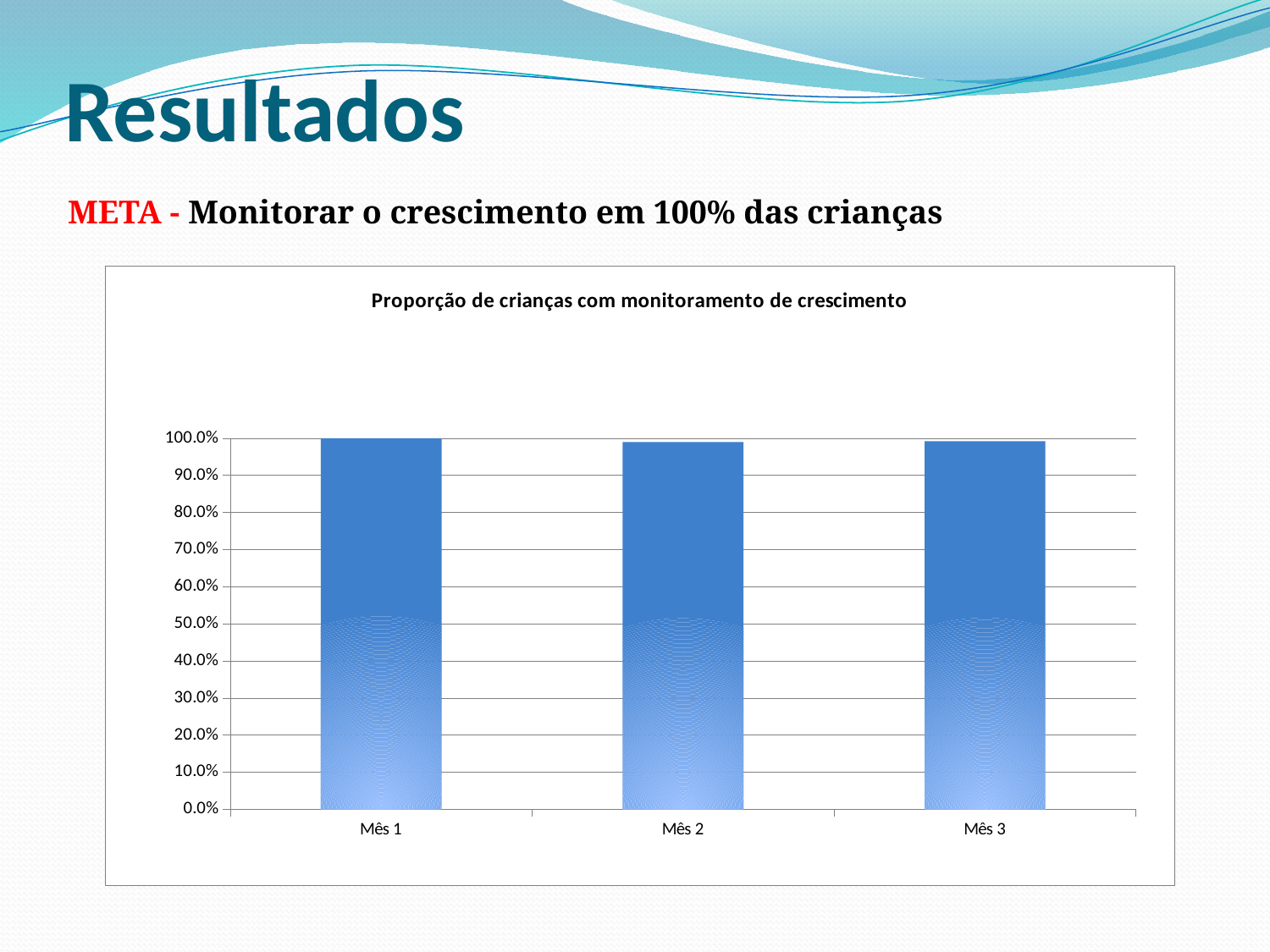
What is the title of the chart? Proporção de crianças com monitoramento de crescimento Is the value for Mês 3 greater or less than 90.0%? greater What is the label of the first category on the x axis? Mês 1 How many categories are shown on the x axis of the chart? 3 Is the value for Mês 2 greater or less than 100.0%? less Which is larger, the value for Mês 1 or the value for Mês 2? Mês 1 What is the value for Mês 1? 100.0% Which category has the highest value? Mês 1 What is the highest value shown on the y axis? 100.0% What kind of chart is shown on the slide? bar chart Is the value for Mês 2 greater or less than 90.0%? greater